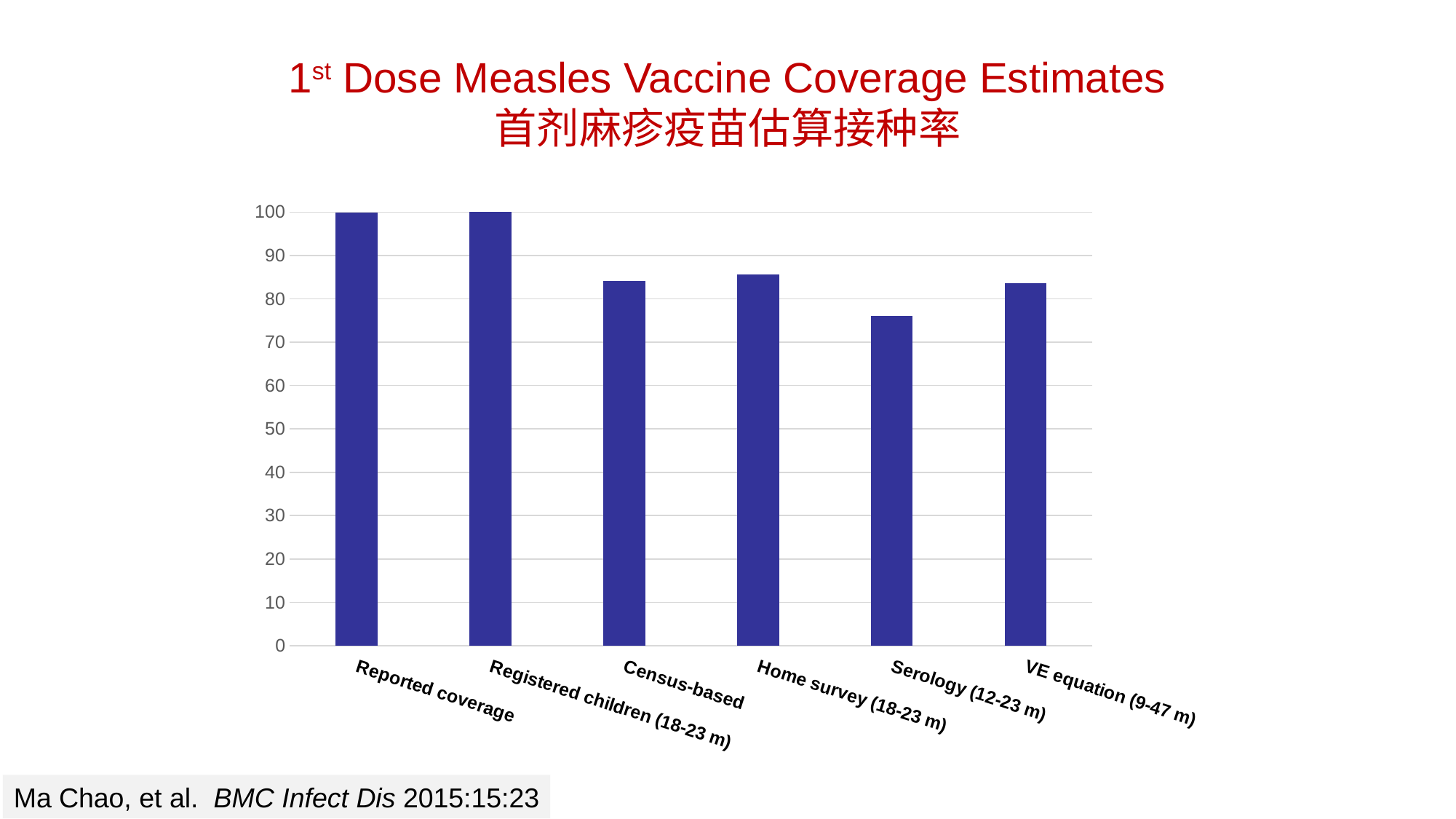
Which category has the lowest coverage estimate? Serology (12-23 m) Is the value for Serology (12-23 m) greater or less than 70? greater Is the value for Census-based greater or less than 80? greater How many categories (estimation methods) are plotted on the chart? 6 What is the highest value shown on the vertical axis? 100 Is the value for Serology (12-23 m) greater or less than 80? less What kind of chart is shown on the slide? bar chart Which is larger, the value for Census-based or the value for Serology (12-23 m)? Census-based Which is larger, the value for Reported coverage or the value for Serology (12-23 m)? Reported coverage